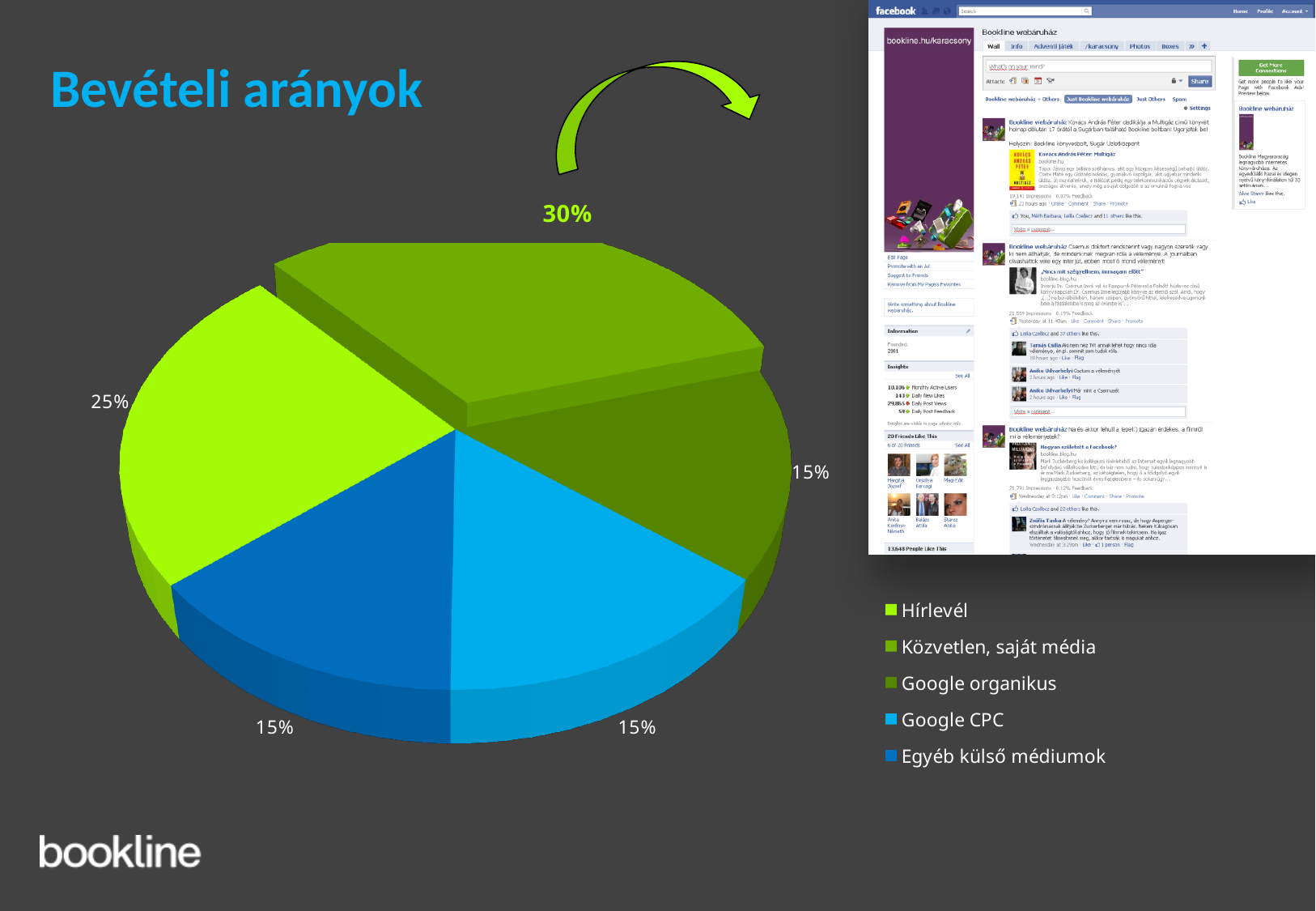
What is the largest share shown in the pie chart? 30% What share does the exploded (pulled-out) slice represent? 30% What kind of chart is shown on the slide? pie chart What share does the Google CPC slice represent? 15% What is the difference between the largest slice (30%) and the Hírlevél slice (25%)? 5 percentage points What is the smallest share shown in the pie chart? 15% How many slices does the pie chart have? 5 How many slices are labelled 15%? 3 How many entries does the legend list? 5 What is the title of the chart? Bevételi arányok What share does the Hírlevél slice represent? 25% Which is larger, the Hírlevél slice or the Google CPC slice? Hírlevél